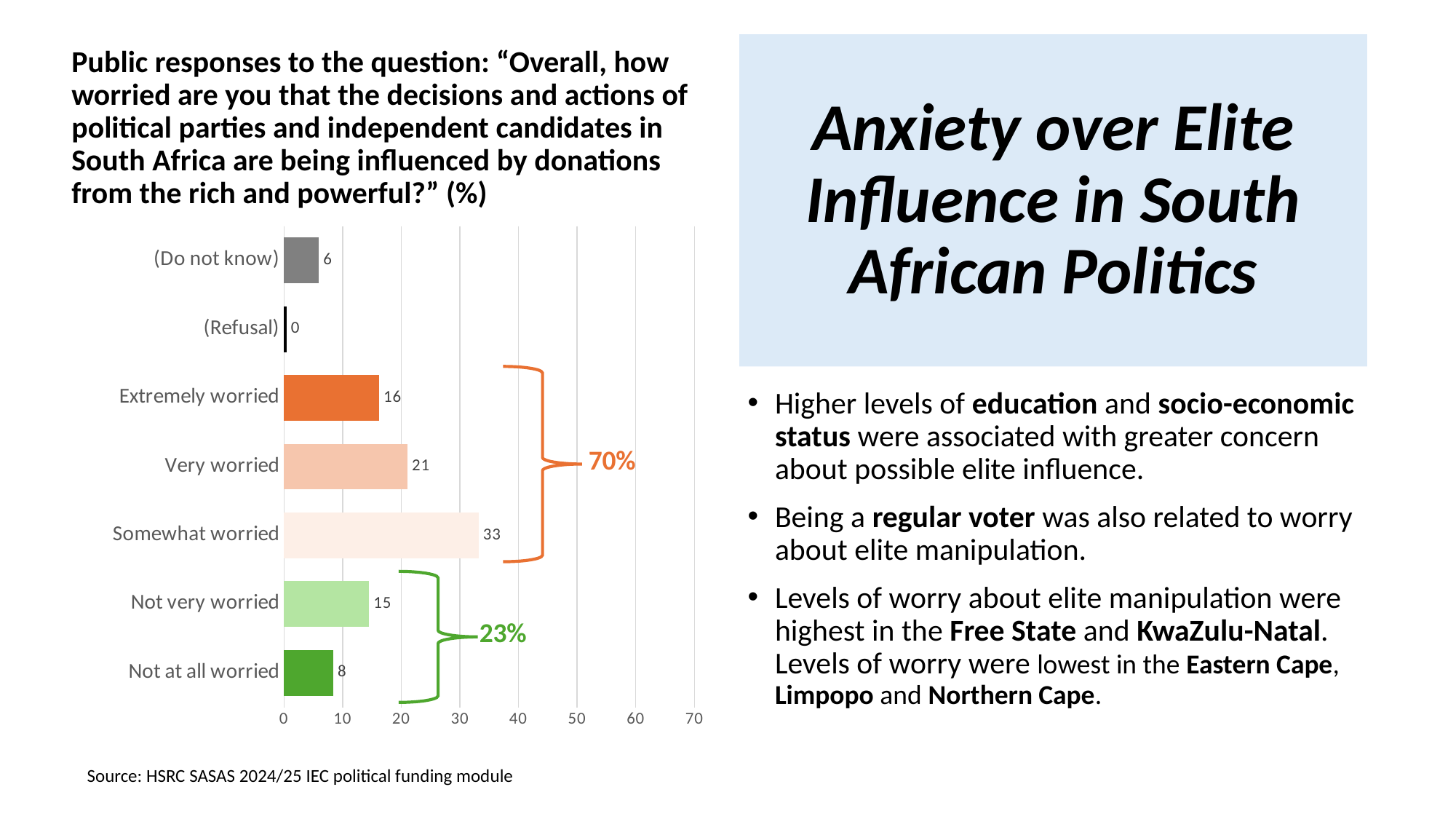
What combined percentage is shown by the green bracket grouping the not worried categories? 23% What is the difference between the values for 'Very worried' and 'Not very worried'? 6 Which response category has the lowest value? (Refusal) What value is shown for 'Not at all worried'? 8 What combined percentage is shown by the orange bracket grouping the worried categories? 70% What kind of chart is shown on the slide? Bar chart How many response categories are shown on the chart? 7 Is the value for 'Somewhat worried' greater or less than 30? greater What value is shown for 'Extremely worried'? 16 Which is larger, the value for 'Extremely worried' or the value for 'Not very worried'? Extremely worried Which response category has the highest value? Somewhat worried What percentage of respondents said they were 'Somewhat worried'? 33